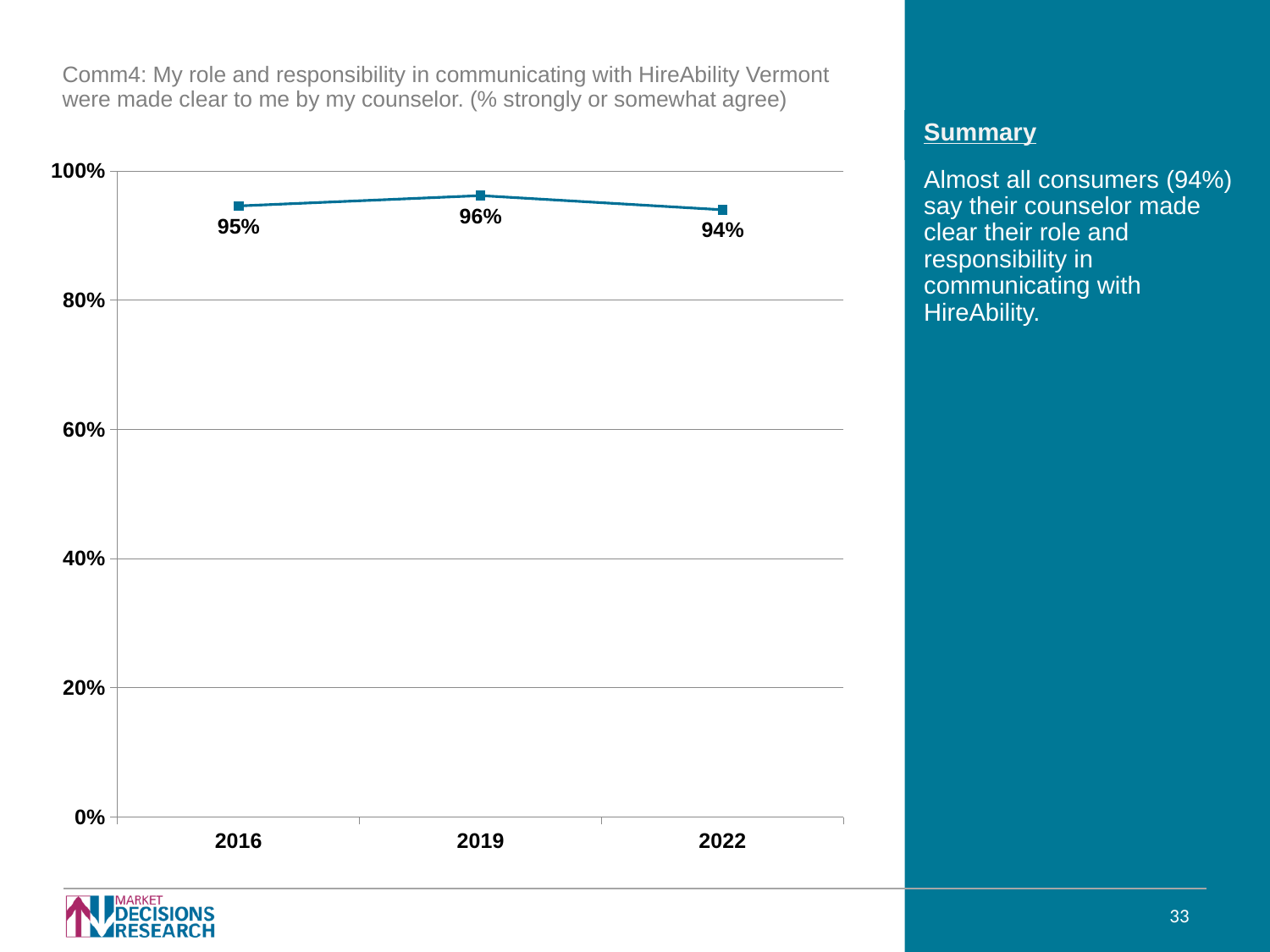
What is the value for 2022? 94% What is the value for 2016? 95% Which year has the highest value? 2019 Is the value for 2022 greater or less than 80%? greater What kind of chart is shown on the slide? line chart Which year has the lowest value? 2022 Which is larger, the value for 2016 or the value for 2022? 2016 What is the value for 2019? 96% What is the difference between the values for 2019 and 2022? 2% What is the highest value shown on the vertical axis? 100% Does the value rise or fall from 2019 to 2022? fall How many years are plotted on the chart? 3